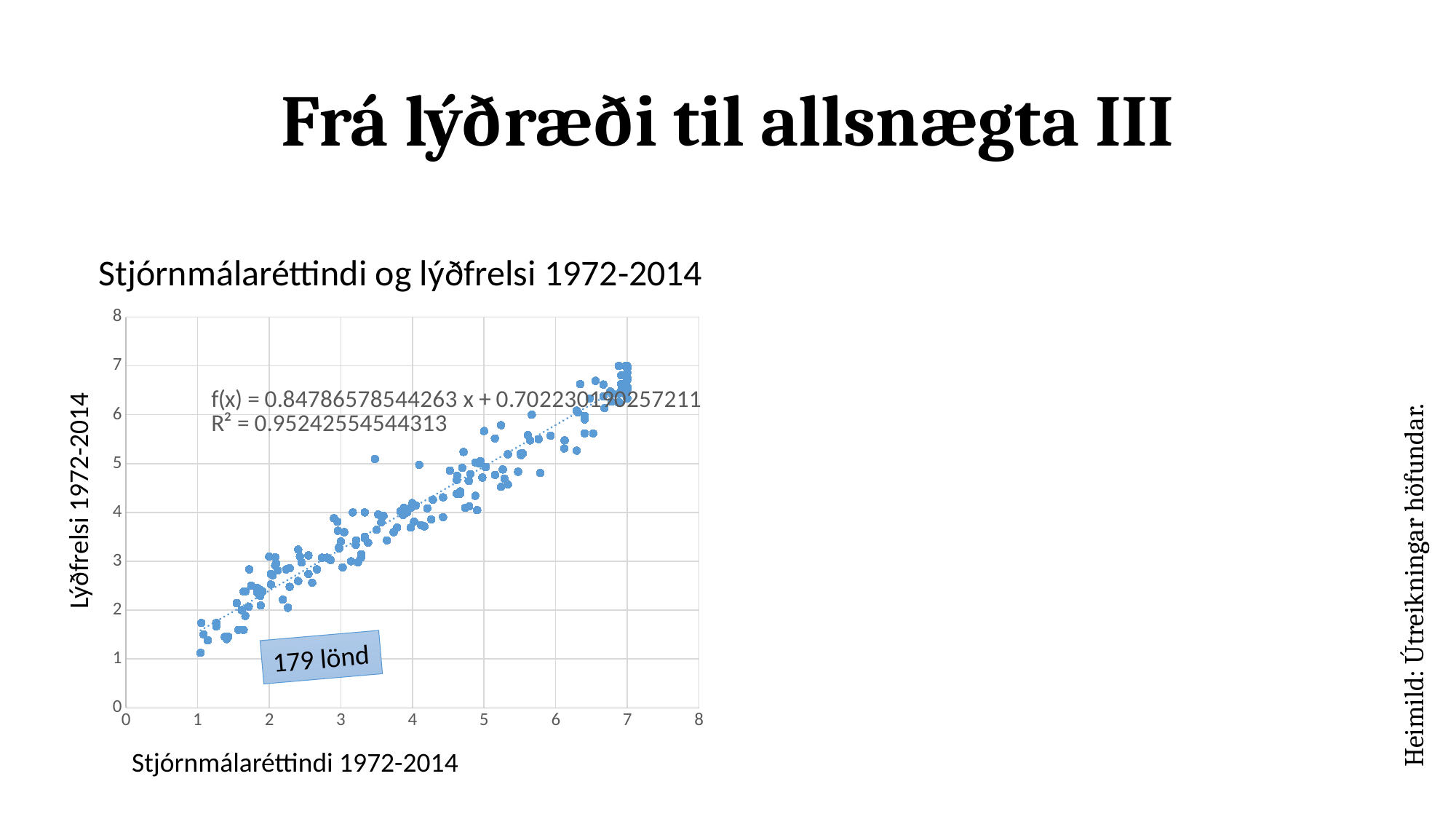
Is the slope of the fitted line greater or less than 1? less What kind of chart is shown on the slide? Scatter chart What is the label of the x axis? Stjórnmálaréttindi 1972-2014 What is the R² value shown on the chart? 0.95242554544313 What is the highest tick value shown on the y axis? 8 How many countries does the annotation on the chart say are plotted? 179 lönd Do the plotted values rise or fall as the x-axis value increases? Rise What is the slope of the fitted line f(x) shown on the chart? 0.84786578544263 What is the intercept of the fitted line f(x) shown on the chart? 0.702230190257211 Is the R² value shown on the chart greater or less than 0.9? greater What is the title of the chart? Stjórnmálaréttindi og lýðfrelsi 1972-2014